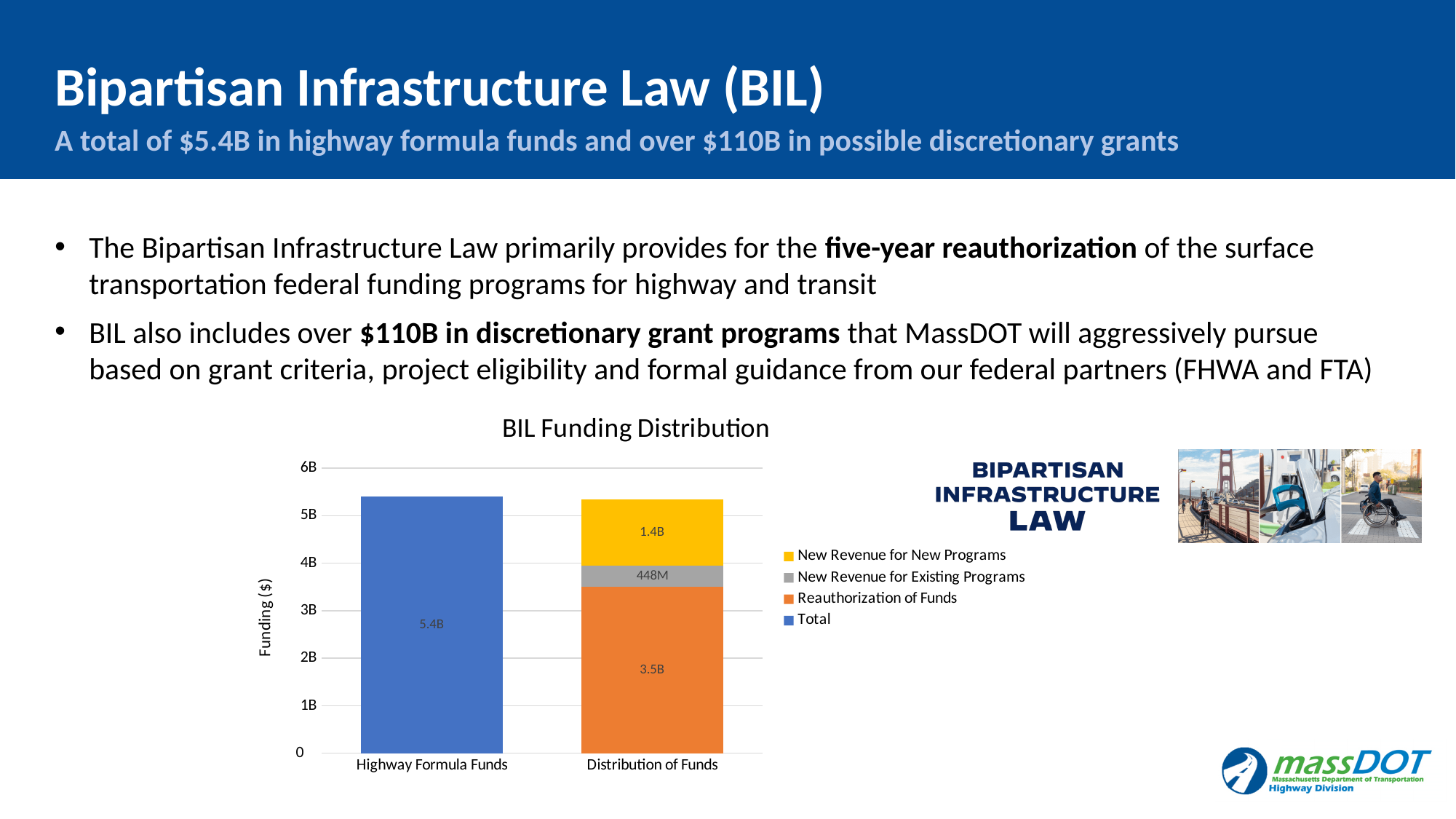
In the BIL Funding Distribution chart, what is the value of the Highway Formula Funds bar? 5.4B How many categories are shown on the x axis of the BIL Funding Distribution chart? 2 In the Distribution of Funds bar, what is the difference between Reauthorization of Funds and New Revenue for New Programs? 2.1B In the BIL Funding Distribution chart, what is the New Revenue for Existing Programs value in the Distribution of Funds bar? 448M In the BIL Funding Distribution chart, what is the Reauthorization of Funds value in the Distribution of Funds bar? 3.5B How many series does the legend of the BIL Funding Distribution chart list? 4 In the BIL Funding Distribution chart, what is the New Revenue for New Programs value in the Distribution of Funds bar? 1.4B What kind of chart is the BIL Funding Distribution chart? Stacked bar chart In the Distribution of Funds bar, which segment is the smallest? New Revenue for Existing Programs In the Distribution of Funds bar, which is larger: Reauthorization of Funds or New Revenue for New Programs? Reauthorization of Funds Is the value for Highway Formula Funds greater or less than 5B? greater What is the y-axis title of the BIL Funding Distribution chart? Funding ($)